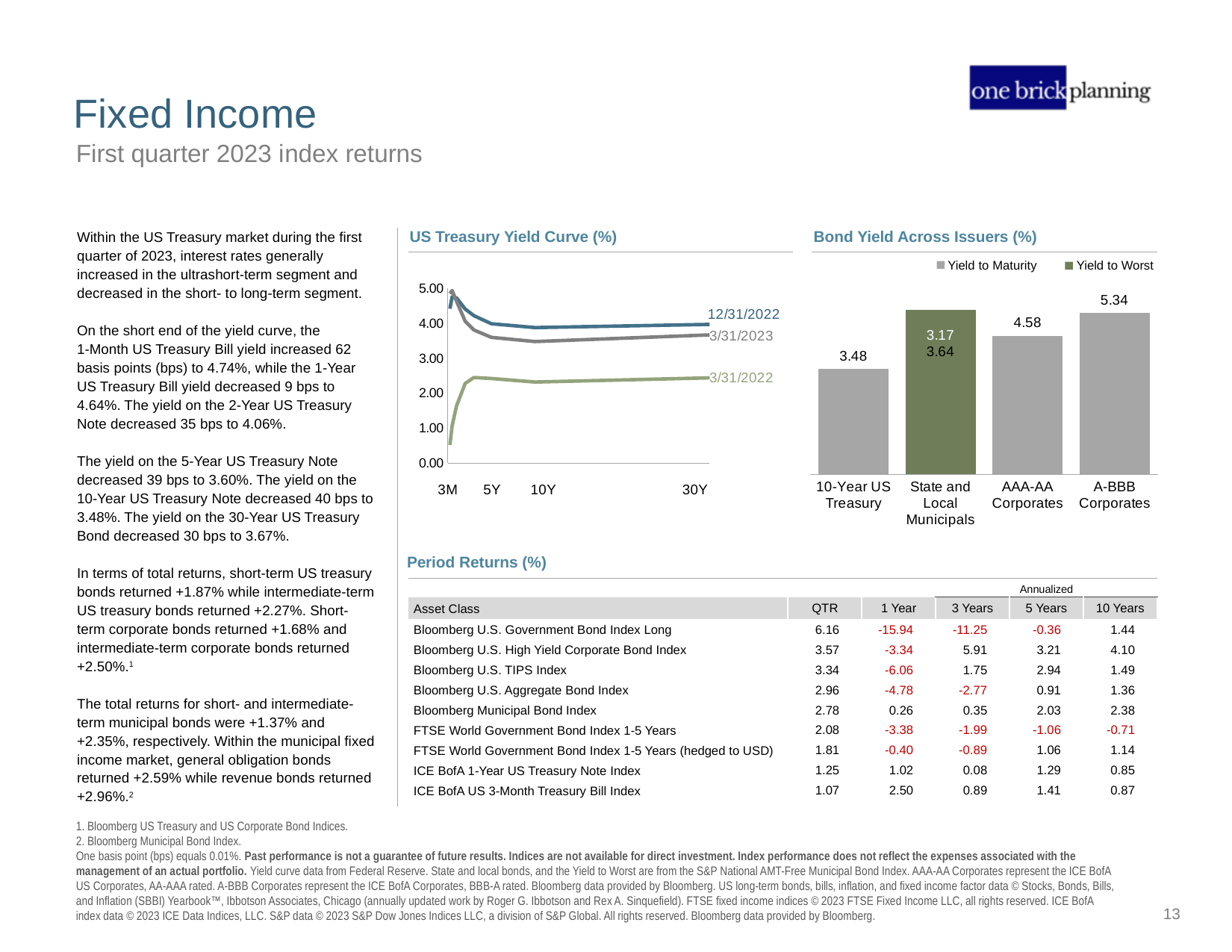
On the Bond Yield Across Issuers (%) chart, what is the value for A-BBB Corporates? 5.34 What are the two legend entries on the Bond Yield Across Issuers (%) chart? Yield to Maturity and Yield to Worst On the Bond Yield Across Issuers (%) chart, what is the value for AAA-AA Corporates? 4.58 On the Bond Yield Across Issuers (%) chart, what is the difference between A-BBB Corporates and AAA-AA Corporates? 0.76 How many series are shown on the US Treasury Yield Curve (%) chart? 3 On the US Treasury Yield Curve (%) chart, is the 12/31/2022 value at 3M greater or less than 4.00? greater On the US Treasury Yield Curve (%) chart, is the 3/31/2022 value at 30Y greater or less than 3.00? less On the Bond Yield Across Issuers (%) chart, what is the value for 10-Year US Treasury? 3.48 What kind of chart is the US Treasury Yield Curve (%) chart? Line chart On the US Treasury Yield Curve (%) chart, does the 3/31/2022 line rise or fall between 3M and 5Y? Rise What kind of chart is the Bond Yield Across Issuers (%) chart? Bar chart On the Bond Yield Across Issuers (%) chart, which is larger: AAA-AA Corporates or 10-Year US Treasury? AAA-AA Corporates